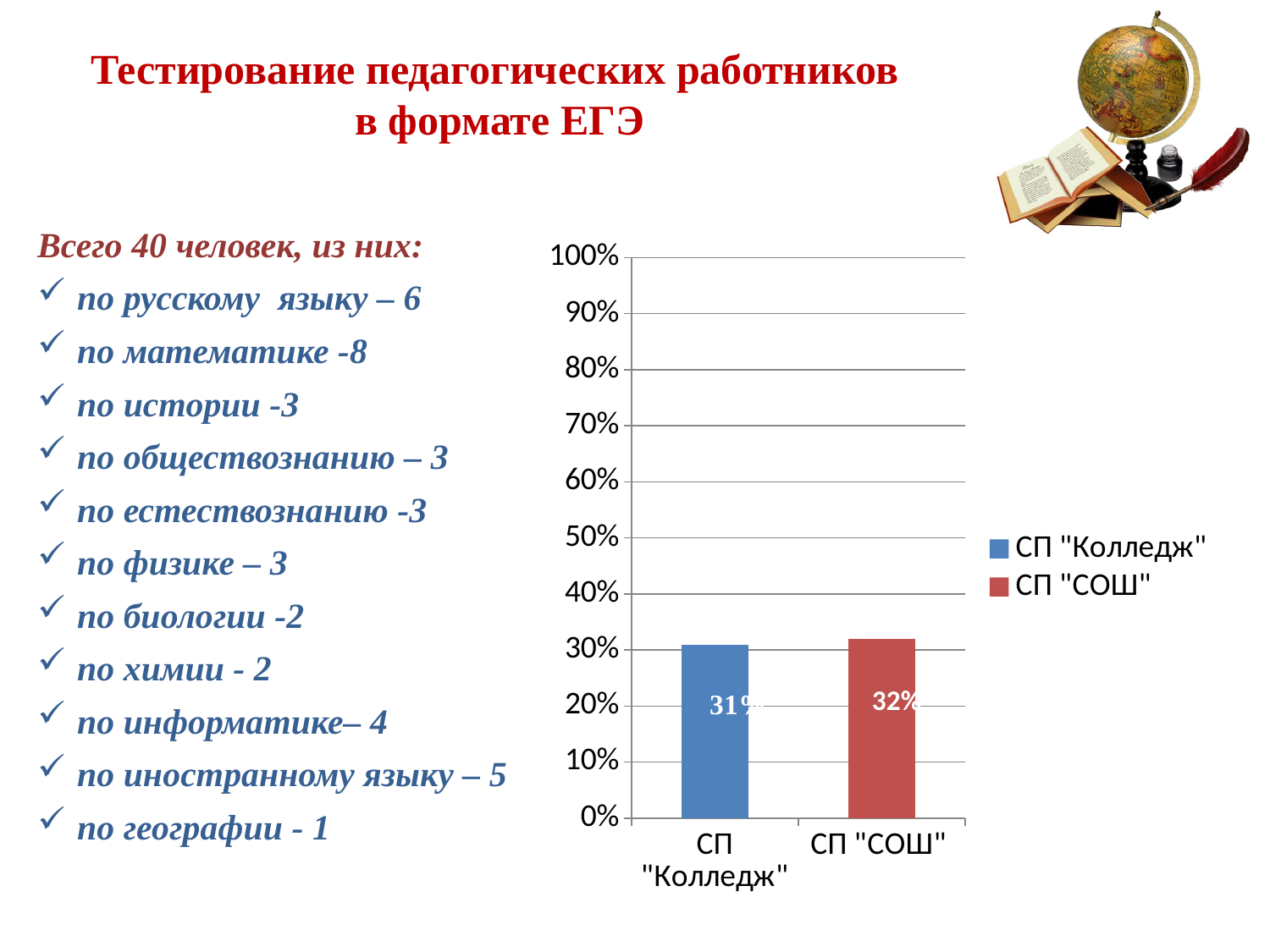
What kind of chart is shown on the slide? bar chart What is the value for СП "СОШ"? 32% What colour is the bar for СП "СОШ"? red What is the maximum value shown on the vertical axis? 100% How many bars are plotted on the chart? 2 Is the value for СП "СОШ" greater or less than 30%? greater What is the difference between the values for СП "СОШ" and СП "Колледж"? 1% Which category has the lowest value on the chart? СП "Колледж" Is the value for СП "Колледж" greater or less than 40%? less Which category has the higher value, СП "Колледж" or СП "СОШ"? СП "СОШ" How many series does the legend list? 2 What is the value for СП "Колледж"? 31%